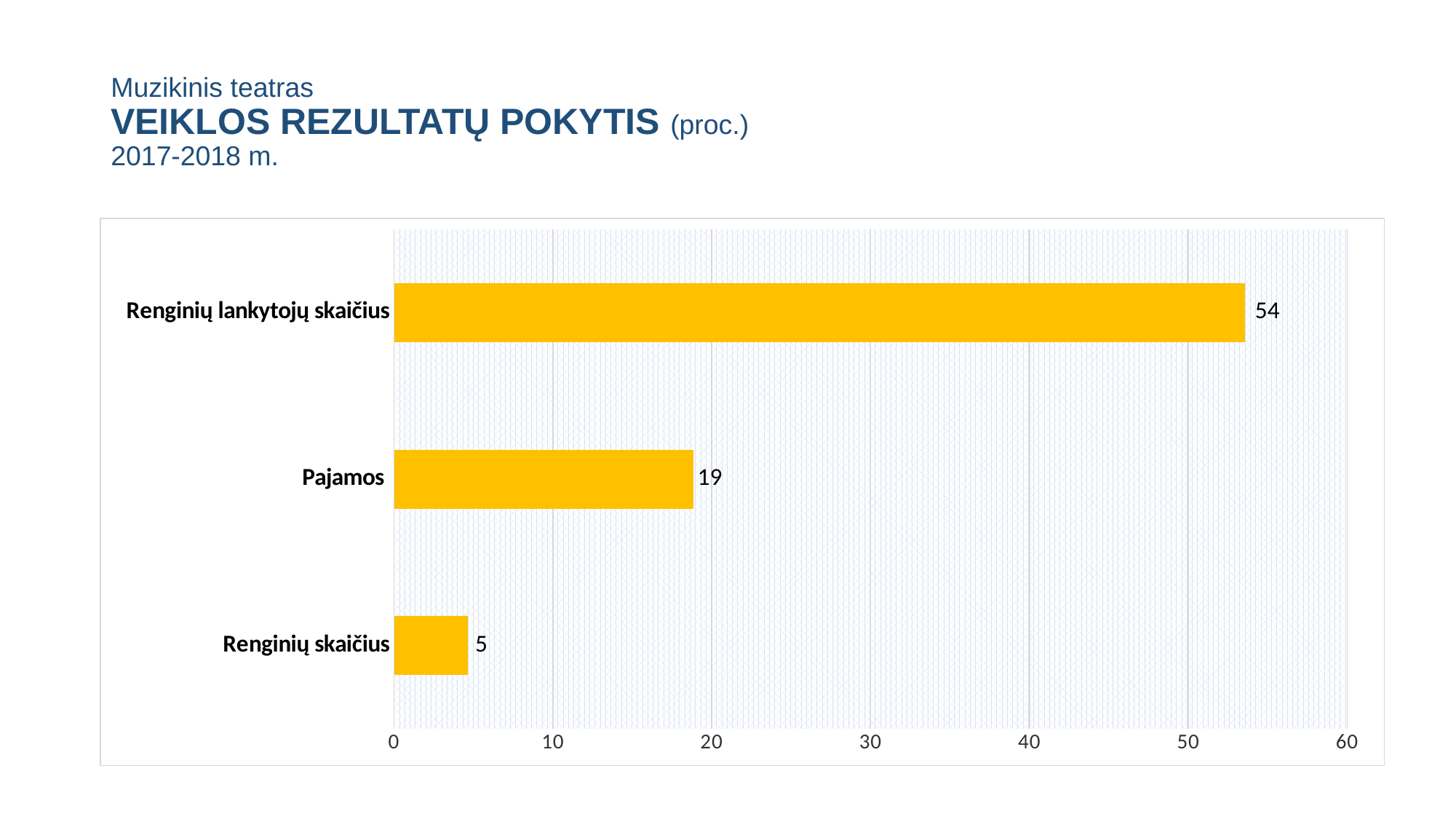
Which category has the lowest value? Renginių skaičius Is the value for Renginių lankytojų skaičius greater or less than 50? greater What is the difference between the values for Renginių lankytojų skaičius and Pajamos? 35 What is the value for Pajamos? 19 What is the value for Renginių lankytojų skaičius? 54 What is the highest value shown on the x axis? 60 What is the difference between the values for Pajamos and Renginių skaičius? 14 Which is larger, the value for Pajamos or the value for Renginių skaičius? Pajamos What is the value for Renginių skaičius? 5 Which category has the highest value? Renginių lankytojų skaičius How many categories are shown in the chart? 3 What kind of chart is shown on the slide? bar chart